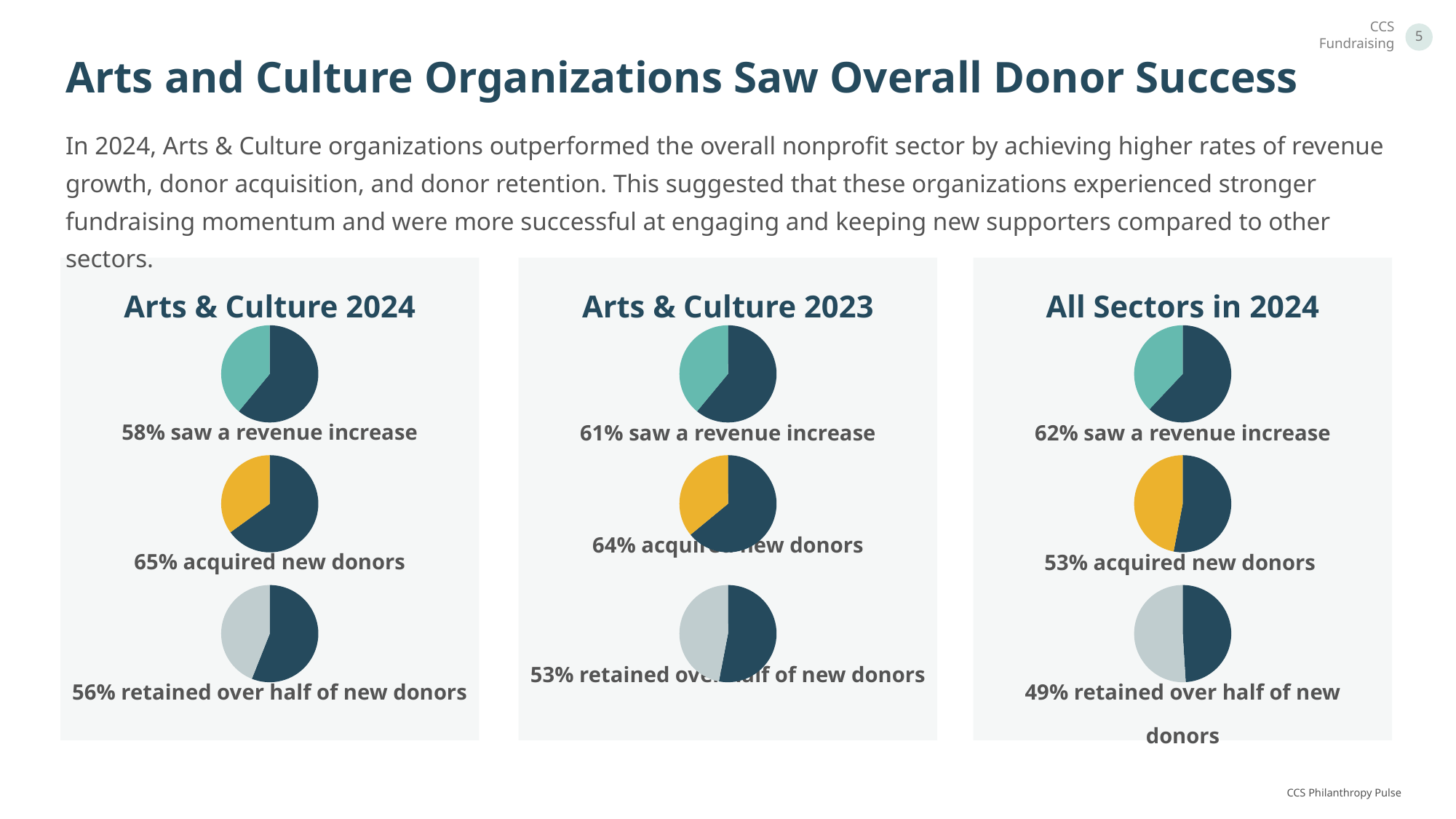
Which is larger: the share that retained over half of new donors in Arts & Culture 2024 or in All Sectors in 2024? Arts & Culture 2024 In the Arts & Culture 2023 panel, what percentage acquired new donors? 64% In the Arts & Culture 2024 panel, what percentage retained over half of new donors? 56% How many pie charts are shown in the Arts & Culture 2023 panel? 3 In the Arts & Culture 2024 panel, what percentage saw a revenue increase? 58% In the All Sectors in 2024 panel, what percentage retained over half of new donors? 49% In the All Sectors in 2024 panel, what percentage saw a revenue increase? 62% What is the difference between the share that acquired new donors in the Arts & Culture 2024 panel and in the All Sectors in 2024 panel? 12 percentage points Which is larger: the share that saw a revenue increase in Arts & Culture 2024 or in Arts & Culture 2023? Arts & Culture 2023 What is the title of the rightmost panel of charts? All Sectors in 2024 What is the difference between the share that retained over half of new donors in Arts & Culture 2024 and in Arts & Culture 2023? 3 percentage points What kind of chart is used in the All Sectors in 2024 panel? Pie chart